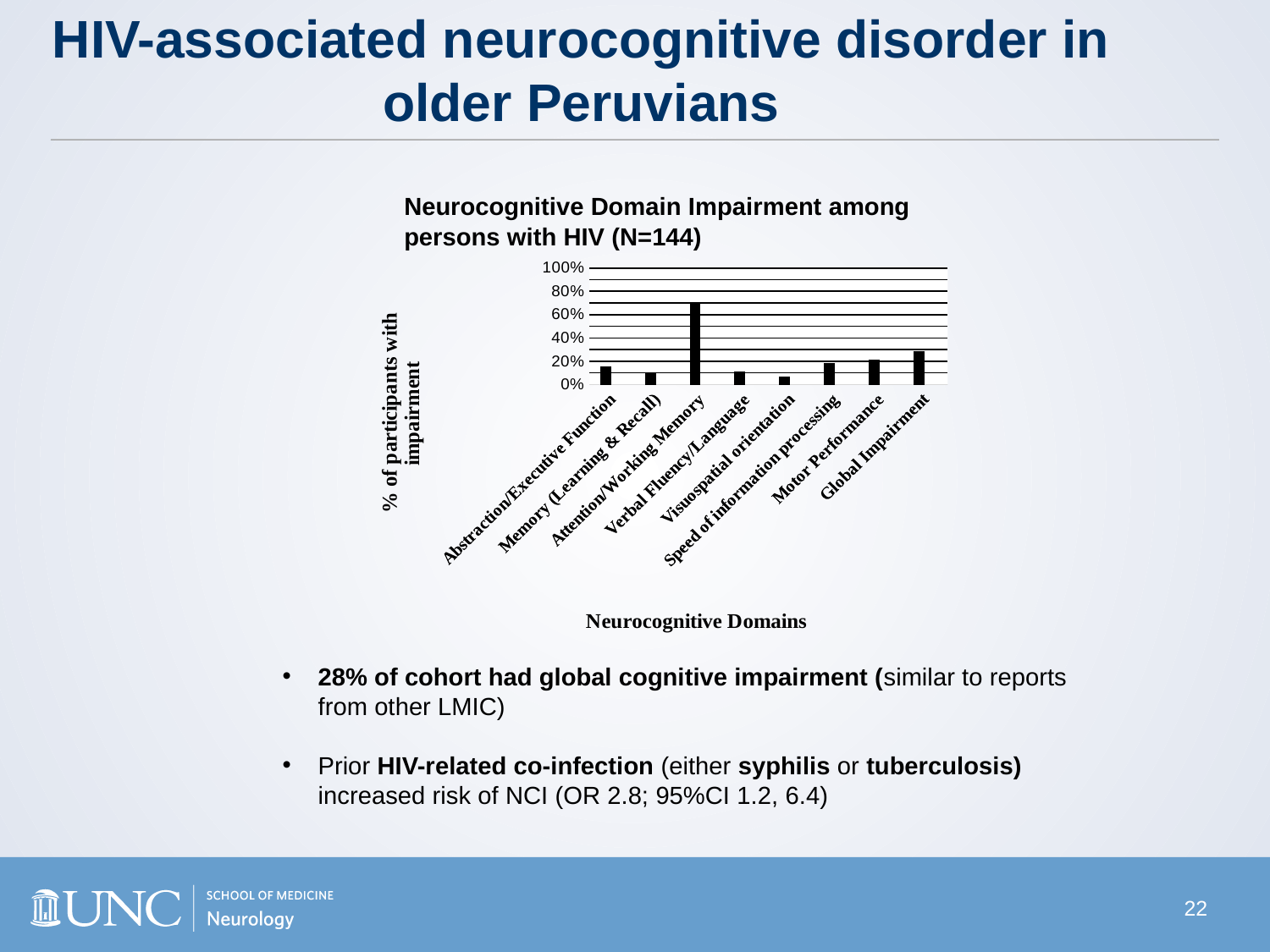
Is the value for Global Impairment greater or less than 20%? greater Which neurocognitive domain has the highest percentage of participants with impairment? Attention/Working Memory Which is larger, the value for Attention/Working Memory or the value for Global Impairment? Attention/Working Memory What is the label on the y axis of the chart? % of participants with impairment Is the value for Visuospatial orientation greater or less than 20%? less Is the value for Memory (Learning & Recall) greater or less than 20%? less How many neurocognitive domains are plotted on the x axis of the chart? 8 What kind of chart is shown on the slide? bar chart What is the title of the chart? Neurocognitive Domain Impairment among persons with HIV (N=144) Which is larger, the value for Global Impairment or the value for Memory (Learning & Recall)? Global Impairment